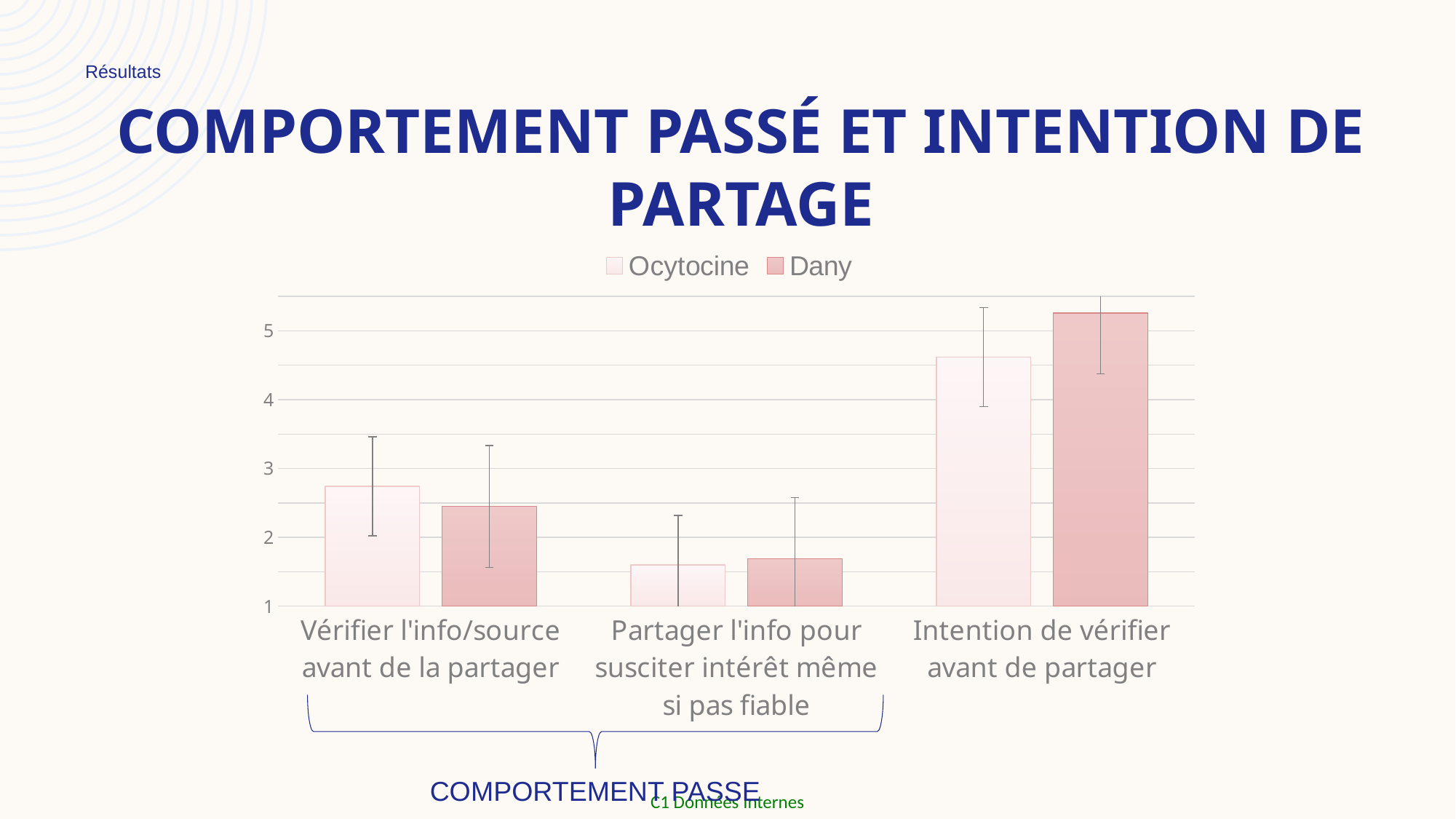
Which category has the highest value for the Ocytocine series? Intention de vérifier avant de partager How many categories are shown on the x axis? 3 Which two categories are grouped under the label 'COMPORTEMENT PASSÉ' below the chart? Vérifier l'info/source avant de la partager and Partager l'info pour susciter intérêt même si pas fiable Is the Dany value for 'Intention de vérifier avant de partager' greater or less than 5? greater Which category has the lowest value for the Dany series? Partager l'info pour susciter intérêt même si pas fiable What kind of chart is shown on the slide? bar chart For 'Intention de vérifier avant de partager', which series has the larger value, Ocytocine or Dany? Dany For 'Vérifier l'info/source avant de la partager', which series has the larger value, Ocytocine or Dany? Ocytocine Is the Ocytocine value for 'Intention de vérifier avant de partager' greater or less than 5? less How many series does the legend list? 2 Is the Ocytocine value for 'Partager l'info pour susciter intérêt même si pas fiable' greater or less than 2? less What are the two series named in the legend? Ocytocine and Dany